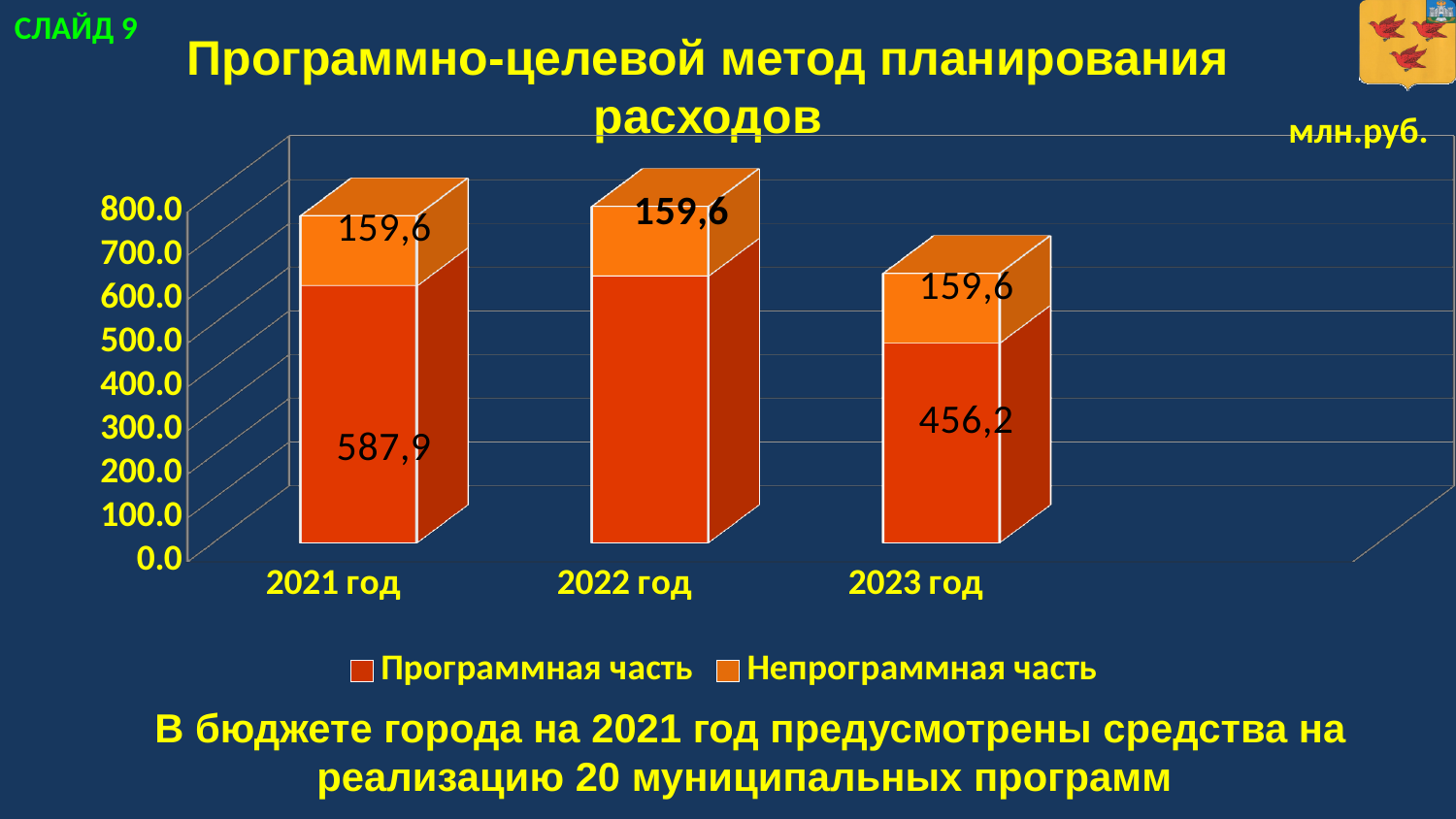
What is the value of Программная часть for 2023 год? 456,2 What is the total of the stacked bar for 2023 год? 615,8 In what units are the chart values given, according to the label at the top right of the chart? млн.руб. What is the value of Непрограммная часть for 2023 год? 159,6 How many years (categories) are shown on the x axis of the chart? 3 What is the value of Непрограммная часть for 2022 год? 159,6 How many series does the chart legend list? 2 What is the difference between the Программная часть values for 2021 год and 2023 год? 131,7 Which year has the larger Программная часть value, 2021 год or 2023 год? 2021 год What is the value of Программная часть for 2021 год? 587,9 What is the total of the stacked bar for 2021 год? 747,5 What kind of chart is shown on the slide? Stacked bar chart